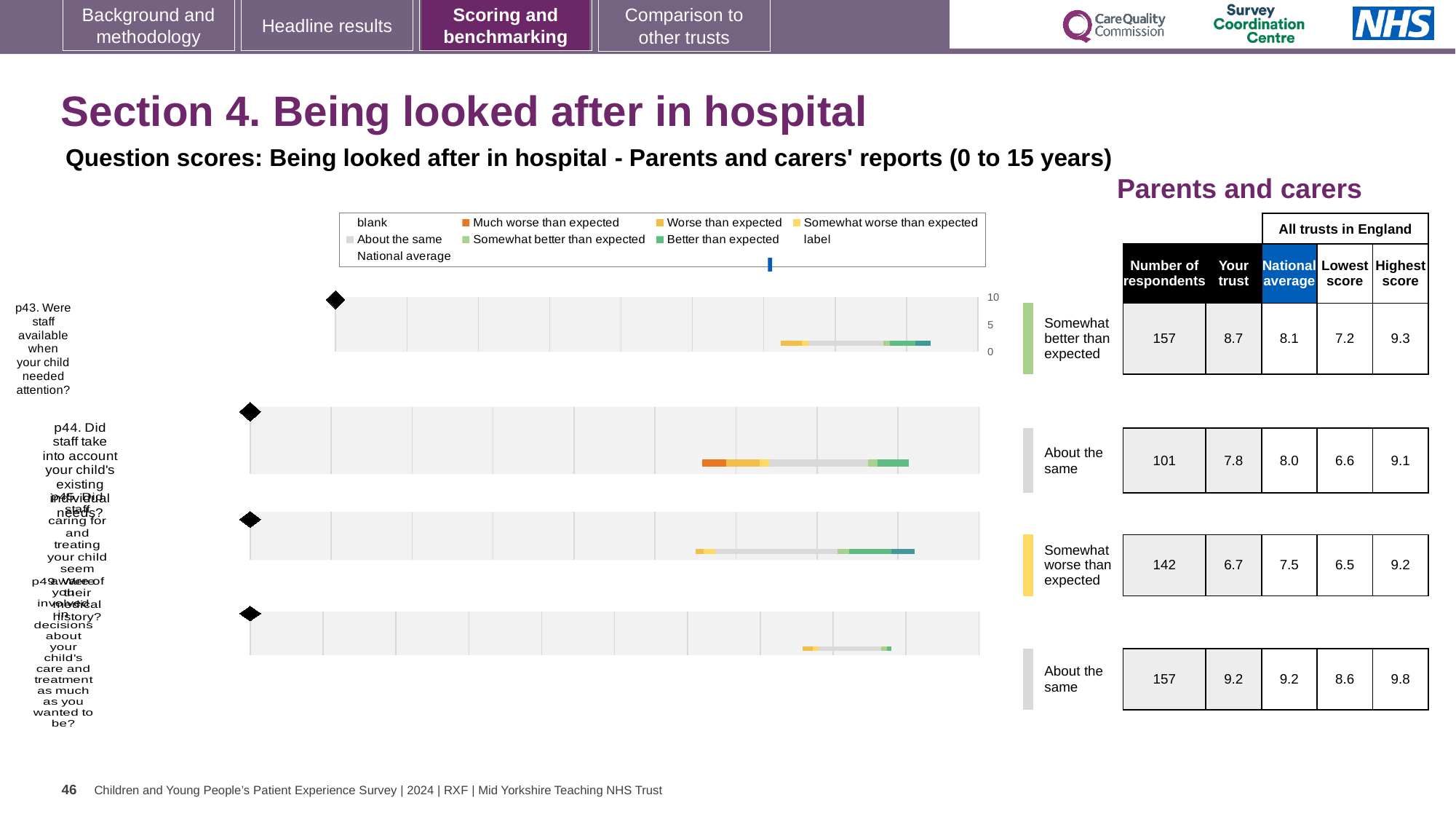
What kind of chart is used to show the question scores on this slide? bar chart For the p45 chart (third row), how many respondents are listed in the table? 142 What benchmark category label is shown next to the p45 chart (third row)? Somewhat worse than expected For the p43 row, what is the difference between the 'Your trust' score (8.7) and the National average (8.1)? 0.6 For the p44 row, which is larger: the 'Your trust' score or the National average? National average Which question row has the highest 'Your trust' score in the table? p49 What benchmark category label is shown next to the p43 chart (top row)? Somewhat better than expected How many question charts (p43, p44, p45, p49) are shown on the slide? 4 For the p49 chart (bottom row), what is the Highest score among all trusts in England? 9.8 For the p44 chart (Did staff take into account your child's existing individual needs?), what is the National average score? 8.0 For the p43 chart (Were staff available when your child needed attention?), what is the 'Your trust' score in the table? 8.7 Which question row has the lowest 'Your trust' score in the table? p45